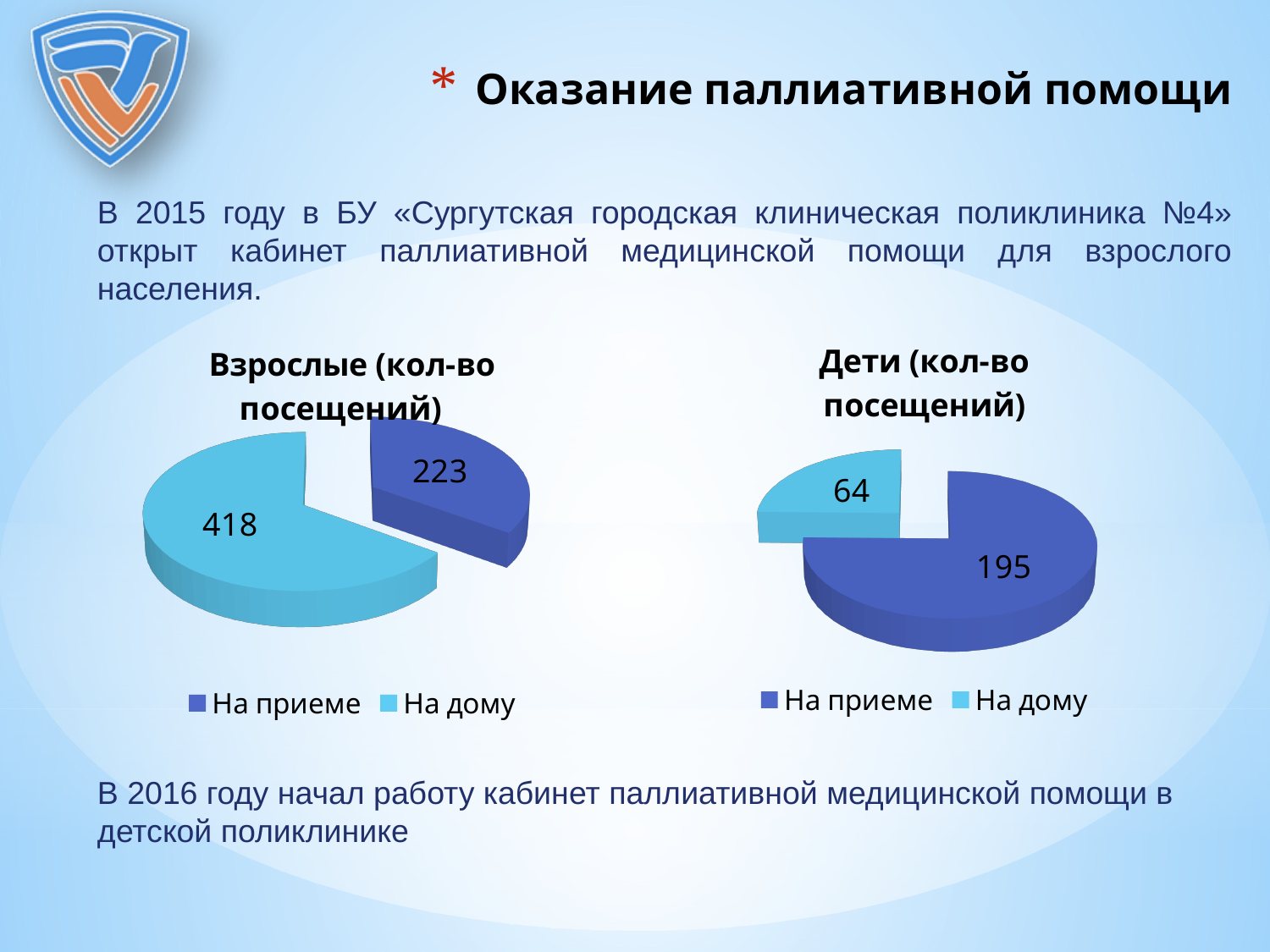
How many series does the legend of the chart titled «Взрослые (кол-во посещений)» list? 2 In the chart titled «Взрослые (кол-во посещений)», what is the value for «На дому»? 418 In the chart titled «Взрослые (кол-во посещений)», what is the difference between «На дому» and «На приеме»? 195 In the chart titled «Дети (кол-во посещений)», what is the value for «На приеме»? 195 Which is larger: «На приеме» in the «Взрослые» chart or «На приеме» in the «Дети» chart? «На приеме» in the «Взрослые» chart In the chart titled «Взрослые (кол-во посещений)», what colour is the «На дому» slice? Light blue In the chart titled «Взрослые (кол-во посещений)», which category has the largest slice? На дому What type of chart is the chart titled «Дети (кол-во посещений)»? Pie chart In the chart titled «Дети (кол-во посещений)», what is the value for «На дому»? 64 In the chart titled «Дети (кол-во посещений)», what is the difference between «На приеме» and «На дому»? 131 In the chart titled «Дети (кол-во посещений)», which category has the smallest slice? На дому In the chart titled «Взрослые (кол-во посещений)», what is the value for «На приеме»? 223